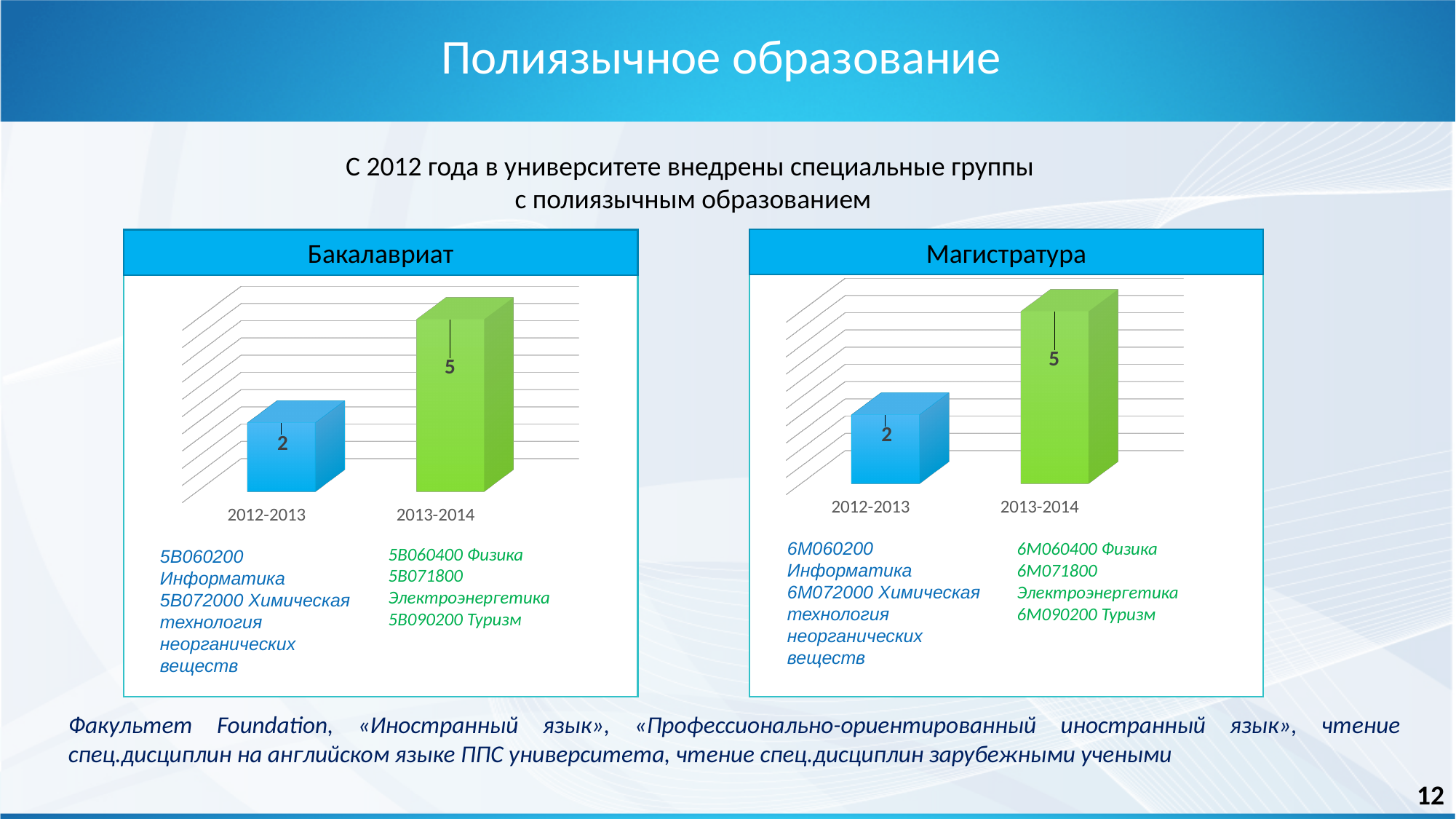
In the Магистратура chart, which is larger, the value for 2012-2013 or 2013-2014? 2013-2014 In the Бакалавриат chart, what is the value for 2013-2014? 5 In the Магистратура chart, what is the value for 2012-2013? 2 In the Магистратура chart, which year has the lowest value? 2012-2013 In the Магистратура chart, what is the difference between the values for 2013-2014 and 2012-2013? 3 How many categories are shown in the Бакалавриат chart? 2 What kind of chart is the Магистратура chart? Bar chart In the Бакалавриат chart, which year has the highest value? 2013-2014 In the Бакалавриат chart, what is the difference between the values for 2013-2014 and 2012-2013? 3 In the Бакалавриат chart, do the values rise or fall from 2012-2013 to 2013-2014? Rise In the Бакалавриат chart, what is the value for 2012-2013? 2 In the Магистратура chart, what is the value for 2013-2014? 5